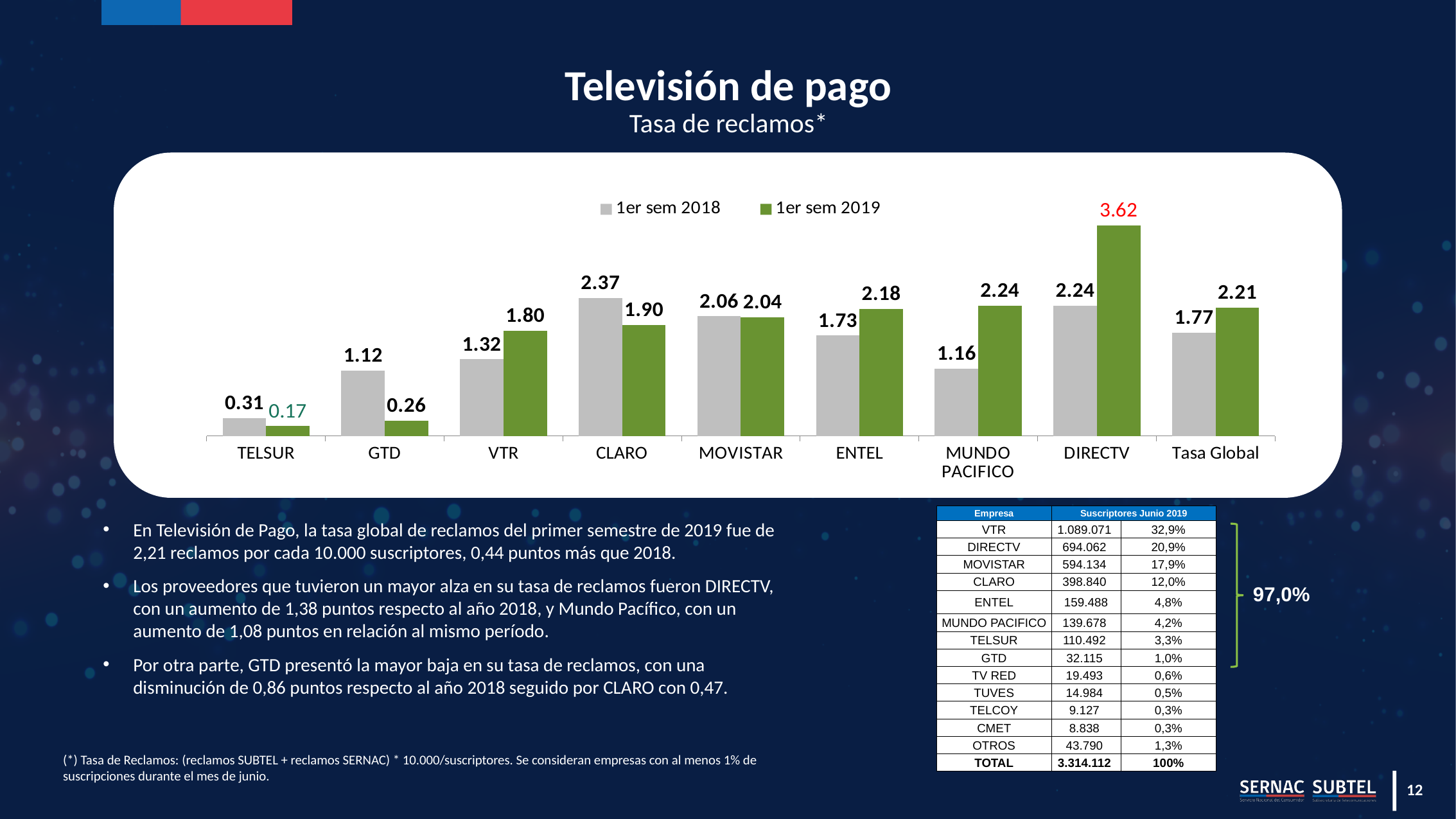
What is the Tasa Global value for 1er sem 2019? 2.21 What is the difference between the 1er sem 2018 and 1er sem 2019 values for GTD? 0.86 What is the value for DIRECTV in the 1er sem 2019 series? 3.62 Which category has the highest value in the 1er sem 2019 series? DIRECTV How many categories are shown on the x axis of the chart? 9 What is the difference between the 1er sem 2019 and 1er sem 2018 values for DIRECTV? 1.38 How many series does the chart legend list? 2 What is the value for GTD in the 1er sem 2018 series? 1.12 What colour are the bars for the 1er sem 2019 series? Green Which is larger for CLARO: the 1er sem 2018 value or the 1er sem 2019 value? 1er sem 2018 Which category has the lowest value in the 1er sem 2018 series? TELSUR What kind of chart is shown on the slide? Bar chart